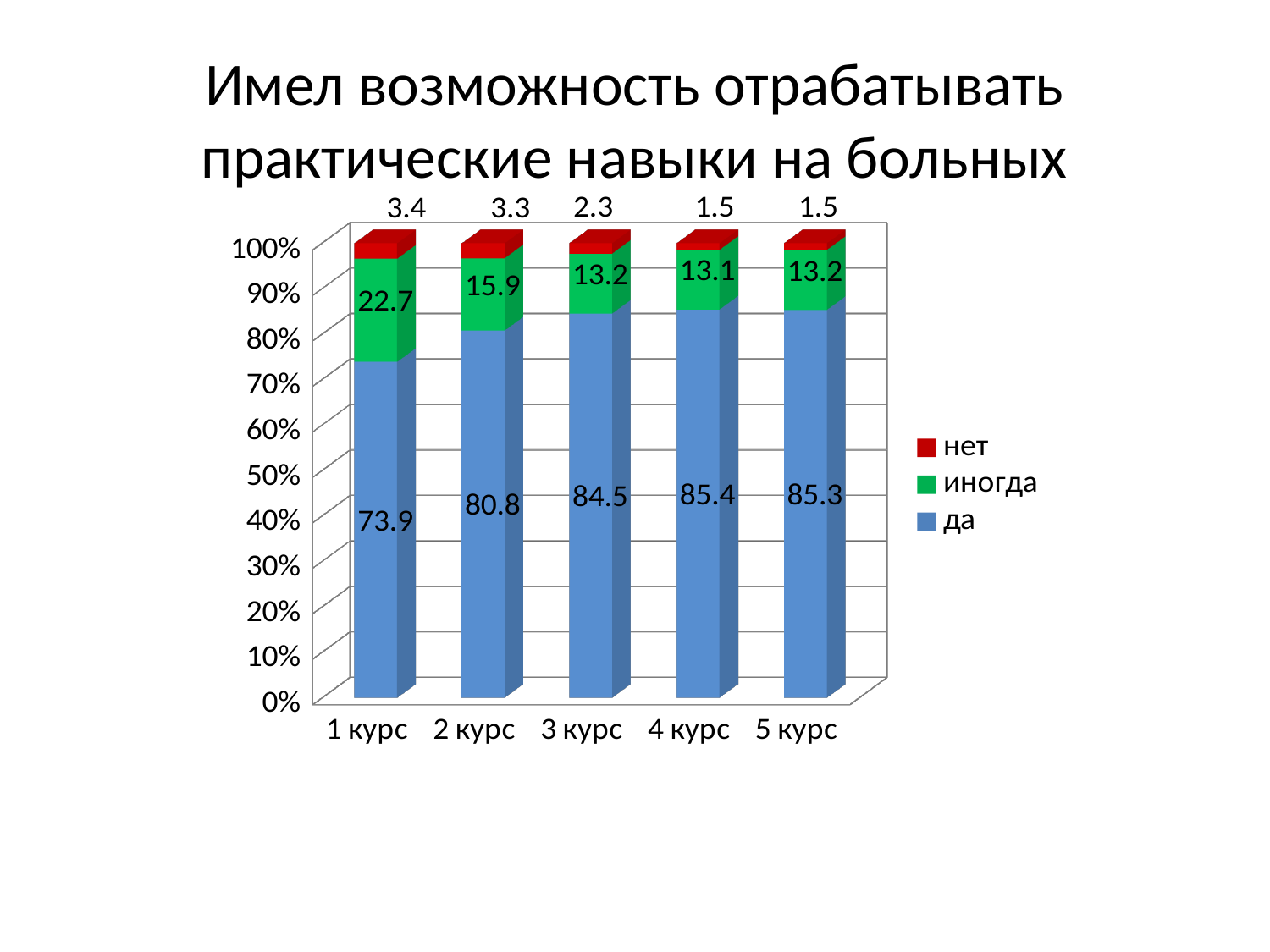
Do the values of the 'нет' series rise or fall from 1 курс to 5 курс? fall How many series does the legend list? 3 Which category has the lowest value for the 'да' series? 1 курс Which is larger: the 'нет' value for 1 курс or for 5 курс? 1 курс Which category has the highest value for the 'иногда' series? 1 курс What is the value of the 'иногда' series for 2 курс? 15.9 What type of chart is shown on the slide? stacked bar chart What is the value of the 'да' series for 4 курс? 85.4 What is the difference between the 'да' values for 2 курс and 1 курс? 6.9 How many categories (курс) are shown on the x axis? 5 What is the value of the 'да' series for 1 курс? 73.9 What is the value of the 'нет' series for 3 курс? 2.3